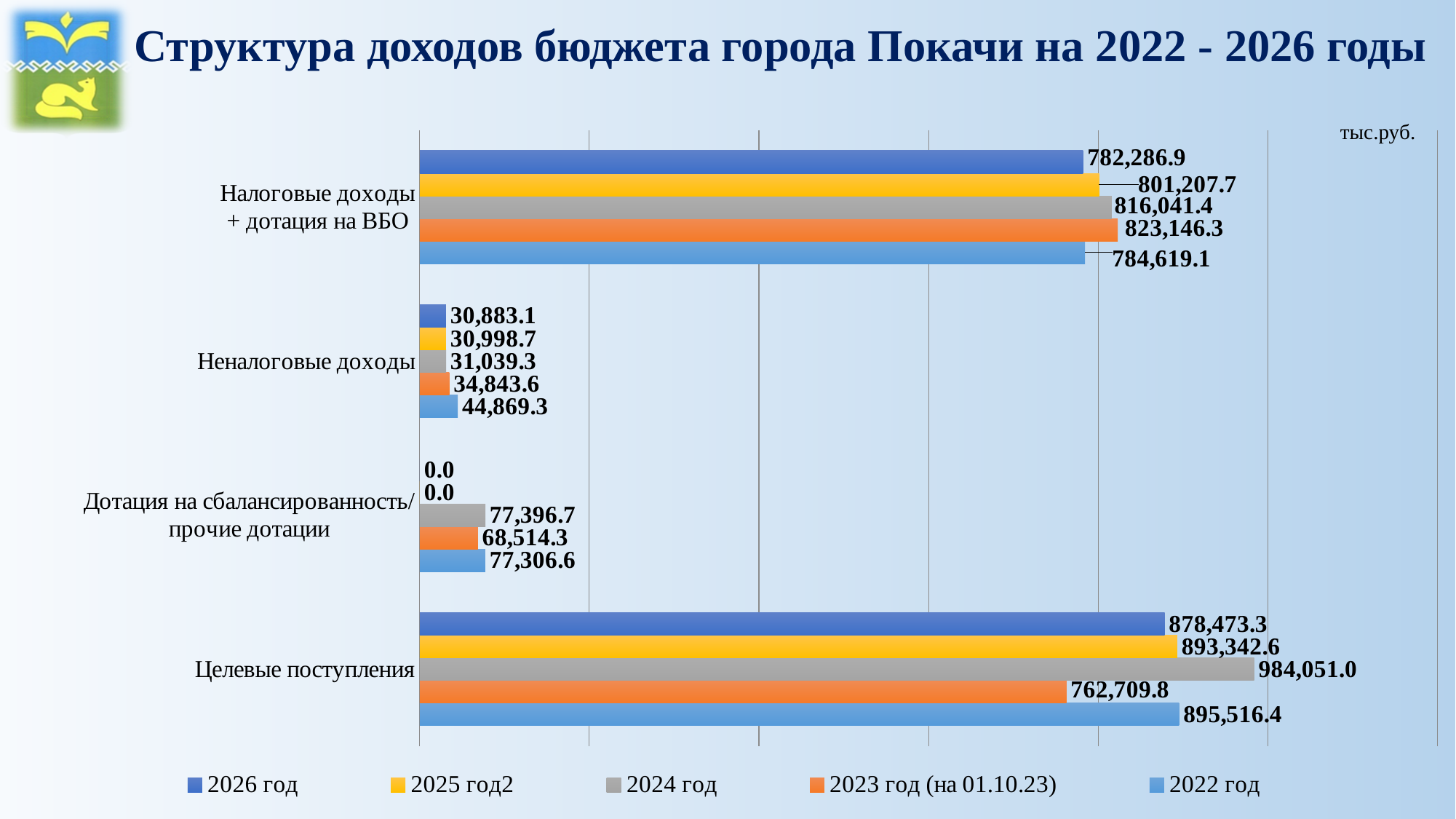
What is the difference between the 2024 год and 2023 год (на 01.10.23) values for Целевые поступления? 221,341.2 What kind of chart is shown on the slide? Bar chart How many series does the legend list? 5 For Дотация на сбалансированность/прочие дотации, which is larger: the 2024 год value or the 2023 год (на 01.10.23) value? 2024 год What is the value for Налоговые доходы + дотация на ВБО in the 2023 год (на 01.10.23) series? 823,146.3 Which year has the lowest value for Неналоговые доходы? 2026 год What is the difference between the 2022 год and 2026 год values for Неналоговые доходы? 13,986.2 Which year has the highest value for Целевые поступления? 2024 год What is the value for Неналоговые доходы in the 2022 год series? 44,869.3 How many categories are shown on the chart? 4 What is the value for Целевые поступления in the 2024 год series? 984,051.0 What is the value for Дотация на сбалансированность/прочие дотации in the 2026 год series? 0.0